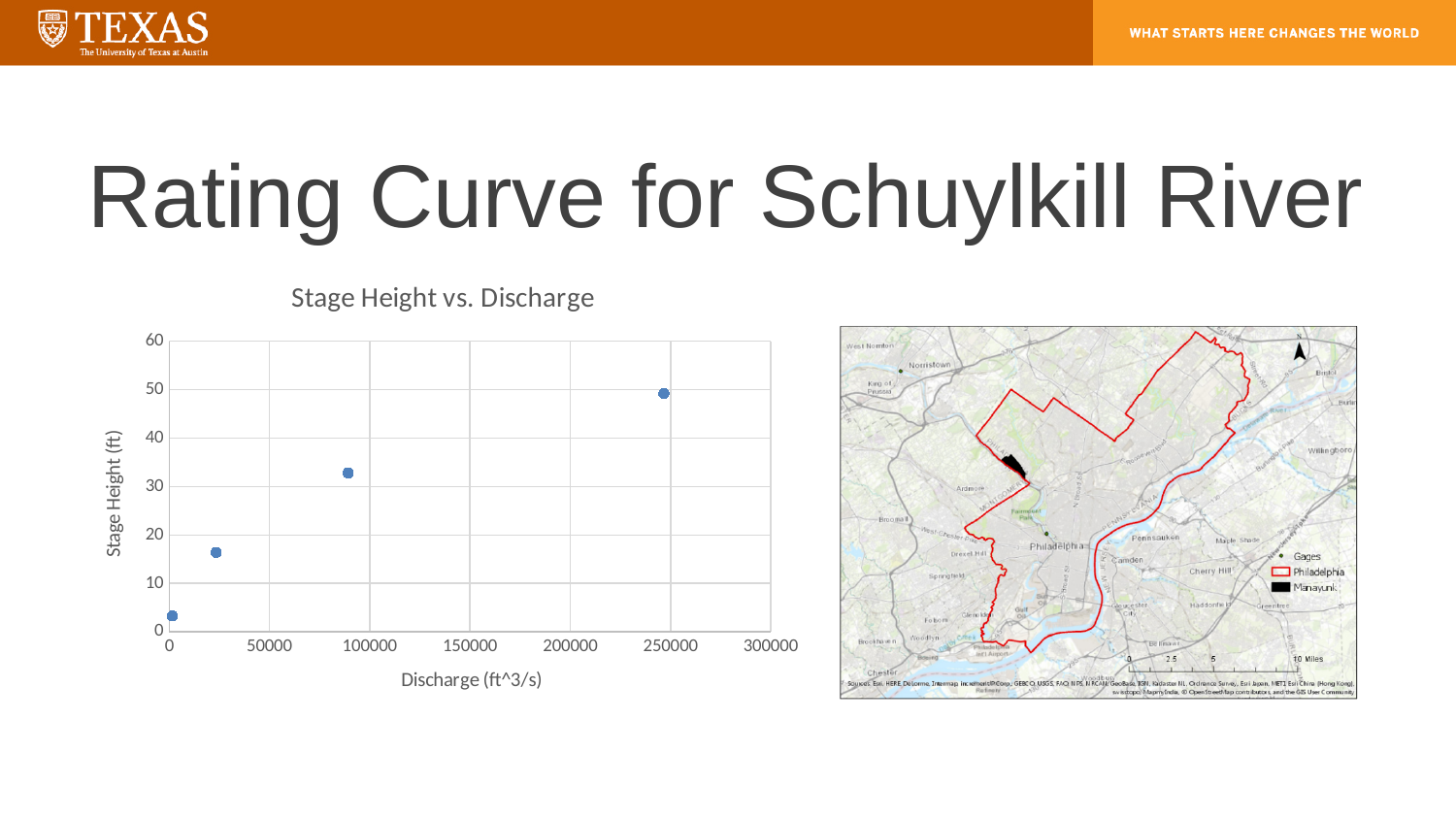
What is the label of the x axis on the 'Stage Height vs. Discharge' chart? Discharge (ft^3/s) What kind of chart is the 'Stage Height vs. Discharge' chart? scatter chart On the 'Stage Height vs. Discharge' chart, is the discharge of the point with a stage height just above 30 greater or less than 100000? less How many data points are plotted on the 'Stage Height vs. Discharge' chart? 4 On the 'Stage Height vs. Discharge' chart, is the stage height of the point with the highest discharge greater or less than 40? greater On the 'Stage Height vs. Discharge' chart, which point has the higher stage height: the one near 250000 ft^3/s discharge or the one near 90000 ft^3/s discharge? the one near 250000 ft^3/s What is the title of the chart on the slide? Stage Height vs. Discharge On the 'Stage Height vs. Discharge' chart, is the stage height of the second-lowest point greater or less than 20? less What is the maximum value shown on the y axis of the 'Stage Height vs. Discharge' chart? 60 On the 'Stage Height vs. Discharge' chart, does stage height rise or fall as discharge increases? rise